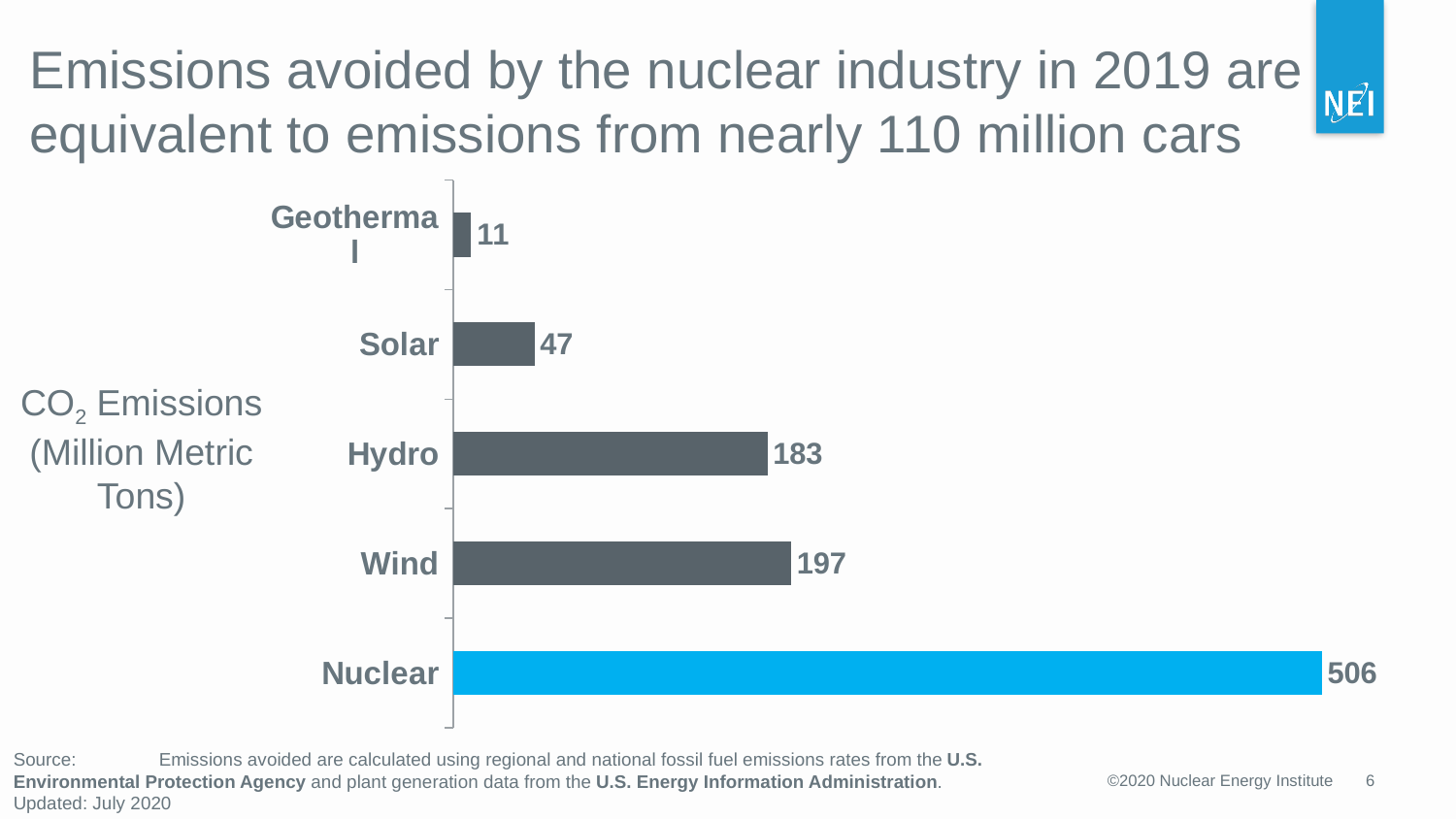
Which is larger, the value for Solar or the value for Hydro? Hydro How many categories are shown in the chart? 5 What is the value for Solar? 47 What is the value for Nuclear? 506 What is the value for Wind? 197 What is the difference between the values for Wind and Hydro? 14 What is the difference between the values for Nuclear and Wind? 309 What is the value for Hydro? 183 Which category has the lowest value? Geothermal Which category has the highest value? Nuclear What is the value for Geothermal? 11 What kind of chart is shown on the slide? Bar chart